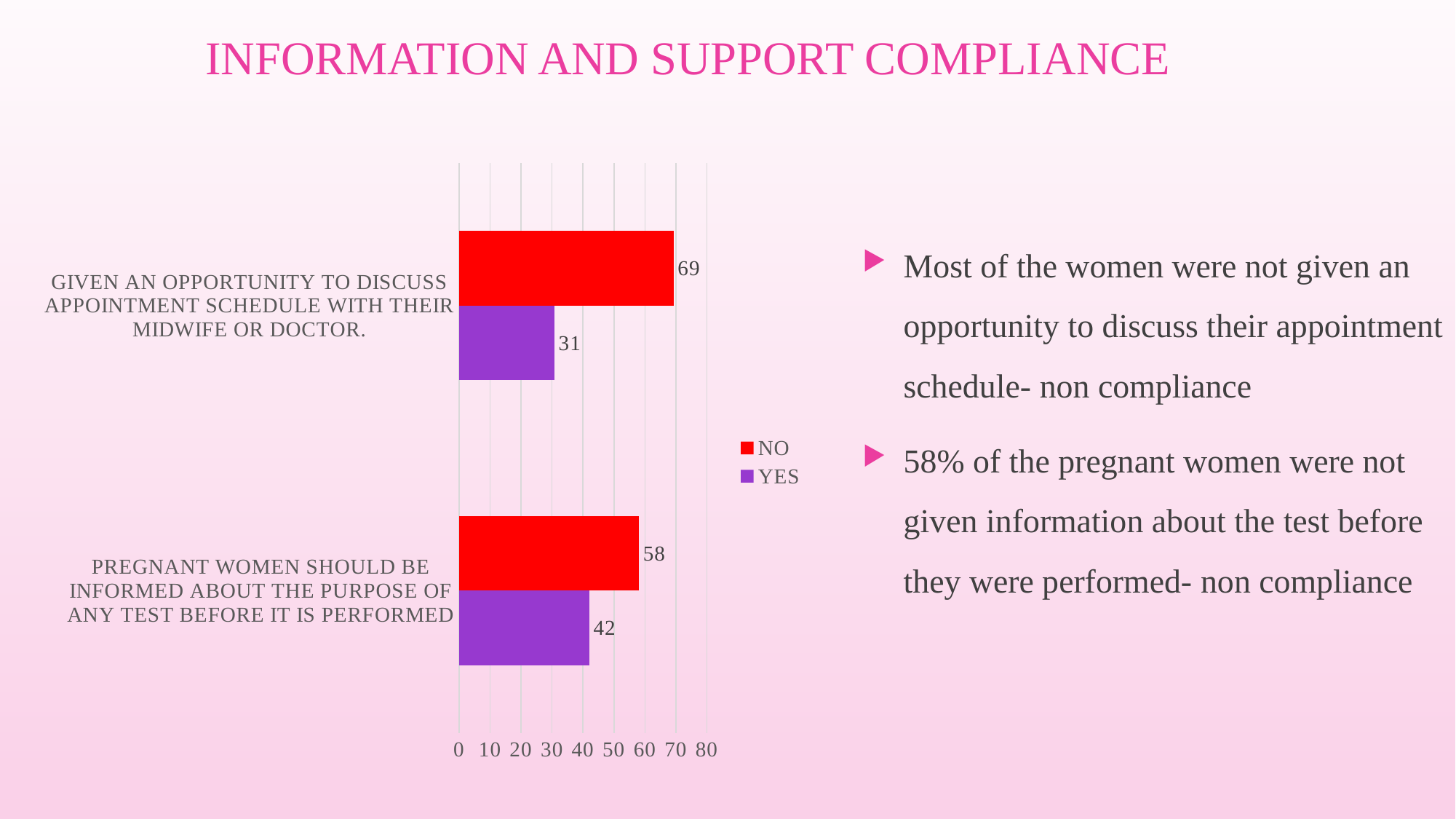
What is the difference between the NO and YES values for 'Given an opportunity to discuss appointment schedule with their midwife or doctor'? 38 For 'Pregnant women should be informed about the purpose of any test before it is performed', which is larger, NO or YES? NO Which category has the highest NO value? Given an opportunity to discuss appointment schedule with their midwife or doctor How many categories are shown on the chart? 2 Which category has the lowest YES value? Given an opportunity to discuss appointment schedule with their midwife or doctor What is the NO value for 'Pregnant women should be informed about the purpose of any test before it is performed'? 58 What is the NO value for 'Given an opportunity to discuss appointment schedule with their midwife or doctor'? 69 What is the YES value for 'Given an opportunity to discuss appointment schedule with their midwife or doctor'? 31 How many series does the legend list? 2 What kind of chart is shown on the slide? Bar chart What is the YES value for 'Pregnant women should be informed about the purpose of any test before it is performed'? 42 What is the difference between the NO and YES values for 'Pregnant women should be informed about the purpose of any test before it is performed'? 16